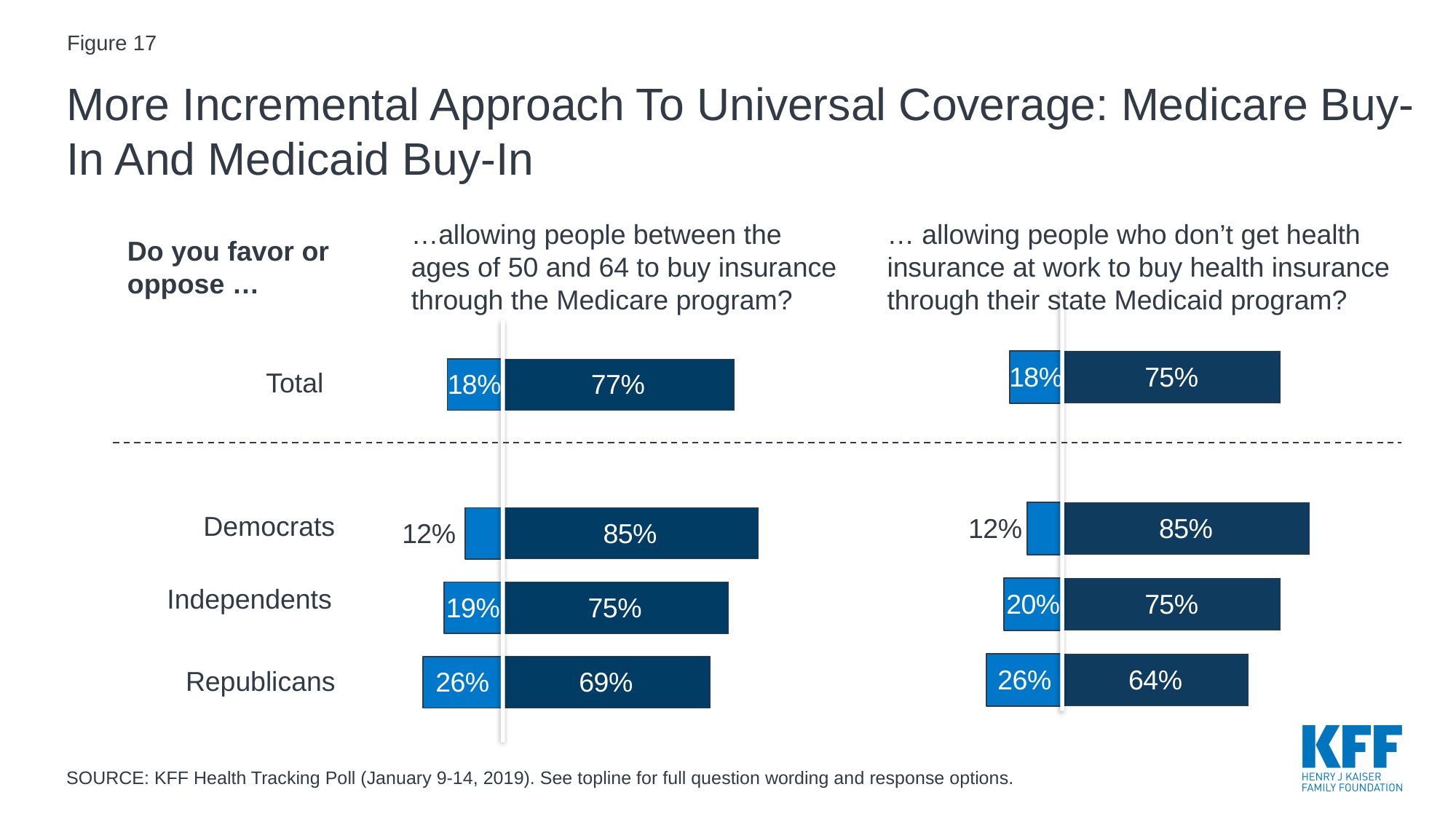
In the left chart (Medicare buy-in), what is the total of the light blue and dark blue values for Total? 95% What type of chart is used on this slide? Bar chart In the right chart (Medicaid buy-in), which group has the lowest dark blue value? Republicans Is the dark blue value for Republicans larger in the left chart (Medicare buy-in) or the right chart (Medicaid buy-in)? Left chart (Medicare buy-in) In the right chart (Medicaid buy-in), what is the value of the dark blue bar for Independents? 75% In the left chart (Medicare buy-in), which group has the highest dark blue value? Democrats In the right chart (Medicaid buy-in), what is the value of the light blue bar for Republicans? 26% In the left chart (Medicare buy-in), which is larger: the light blue value for Independents or for Republicans? Republicans In the left chart (Medicare buy-in for ages 50-64), what is the value of the dark blue bar for Total? 77% In the left chart (Medicare buy-in), what is the difference between the dark blue values for Democrats and Republicans? 16% In the right chart (Medicaid buy-in), what is the difference between the light blue values for Republicans and Democrats? 14% How many groups are shown in each chart? 4